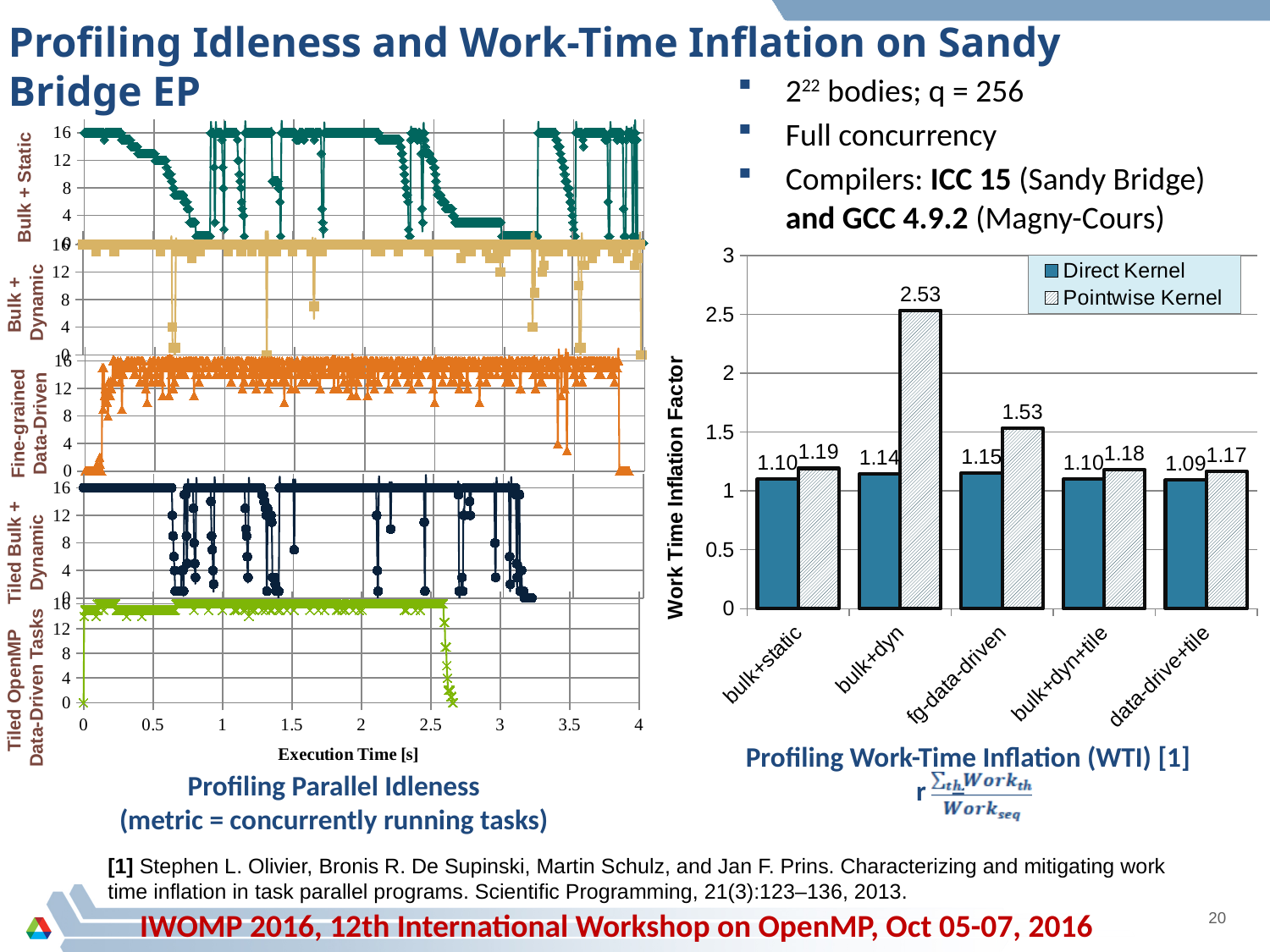
In the Profiling Work-Time Inflation chart, which category has the highest Pointwise Kernel value? bulk+dyn How many categories are shown on the x axis of the Profiling Work-Time Inflation chart? 5 What type of chart is the Profiling Work-Time Inflation chart? bar chart In the Profiling Work-Time Inflation chart, what is the difference between the Pointwise Kernel values for fg-data-driven and bulk+static? 0.34 In the Profiling Work-Time Inflation chart, what is the Pointwise Kernel value for data-drive+tile? 1.17 In the Profiling Work-Time Inflation chart, what is the difference between the Pointwise Kernel and Direct Kernel values for bulk+dyn? 1.39 In the Profiling Work-Time Inflation chart, which category has the lowest Direct Kernel value? data-drive+tile How many series does the legend of the Profiling Work-Time Inflation chart list? 2 In the Profiling Work-Time Inflation chart, what is the Direct Kernel value for fg-data-driven? 1.15 In the Profiling Work-Time Inflation chart, is the Pointwise Kernel value for bulk+dyn greater or less than 2? greater In the Profiling Work-Time Inflation chart, what is the Pointwise Kernel value for bulk+dyn? 2.53 In the Profiling Work-Time Inflation chart, which is larger: the Pointwise Kernel value for fg-data-driven or for bulk+dyn+tile? fg-data-driven